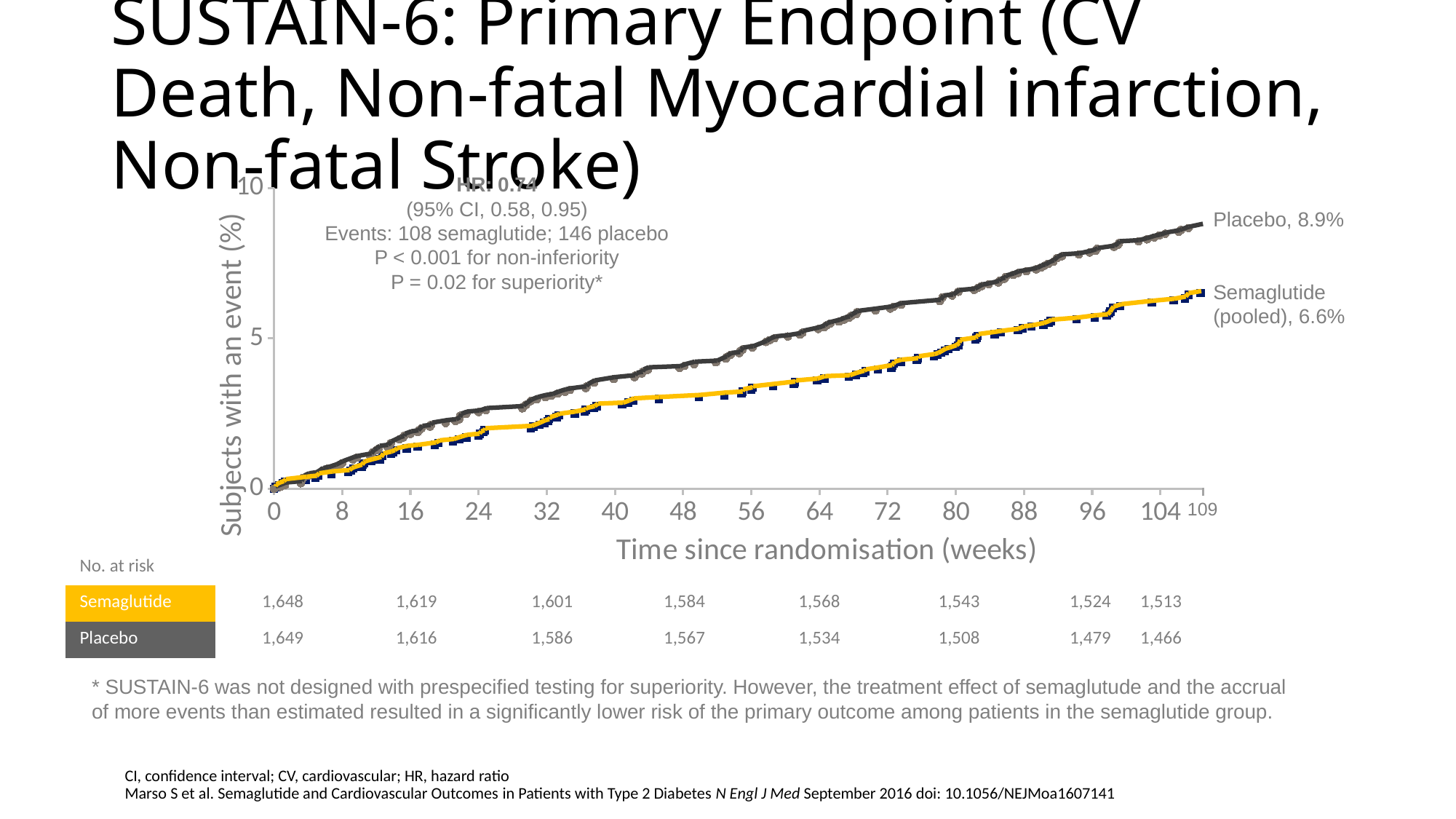
How many series are plotted on the chart? 2 Is the Placebo curve at week 80 greater or less than 5%? greater Is the Semaglutide (pooled) curve at week 104 greater or less than 5%? greater Which series ends with the higher percentage of subjects with an event? Placebo How many events are reported for the placebo group in the chart annotation? 146 What is the difference between the final Placebo and Semaglutide (pooled) event rates? 2.3% Is the Placebo curve at week 56 greater or less than 5%? less What is the final event rate shown for the Semaglutide (pooled) series? 6.6% Do the curves rise or fall as time since randomisation increases? rise What type of chart is shown on the slide? line chart What is the final event rate shown for the Placebo series? 8.9% What is the label of the x axis? Time since randomisation (weeks)